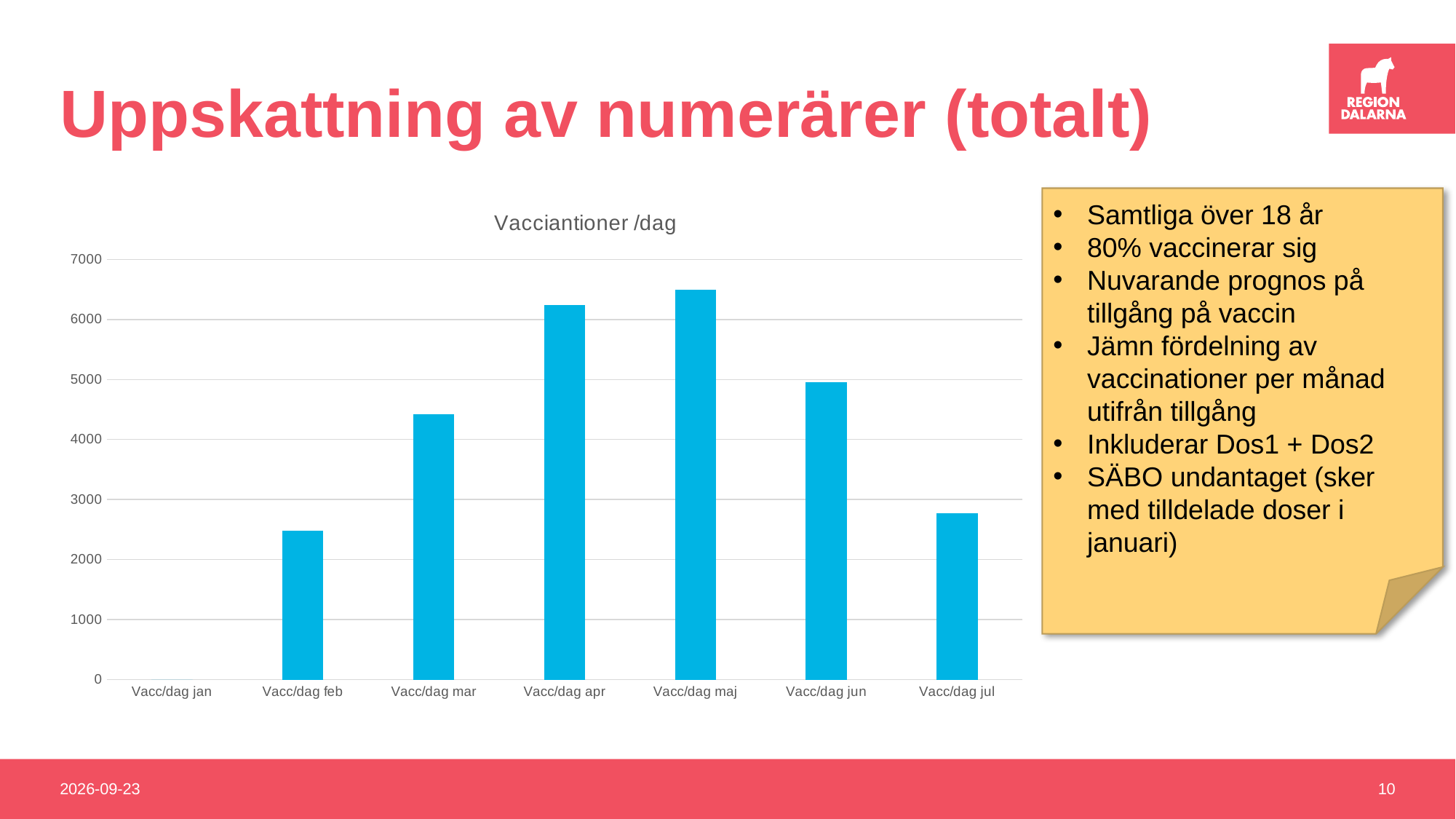
Is the value for Vacc/dag jul greater or less than 3000? less Is the value for Vacc/dag jun greater or less than 4000? greater How many categories are shown on the x axis of the chart? 7 What kind of chart is shown on the slide? bar chart Is the value for Vacc/dag apr greater or less than 6000? greater Which category has the highest bar in the chart? Vacc/dag maj Do the values rise or fall from Vacc/dag maj to Vacc/dag jul? fall Which category has no visible bar in the chart? Vacc/dag jan Which is larger, the value for Vacc/dag mar or Vacc/dag jun? Vacc/dag jun What is the title of the chart? Vacciantioner /dag